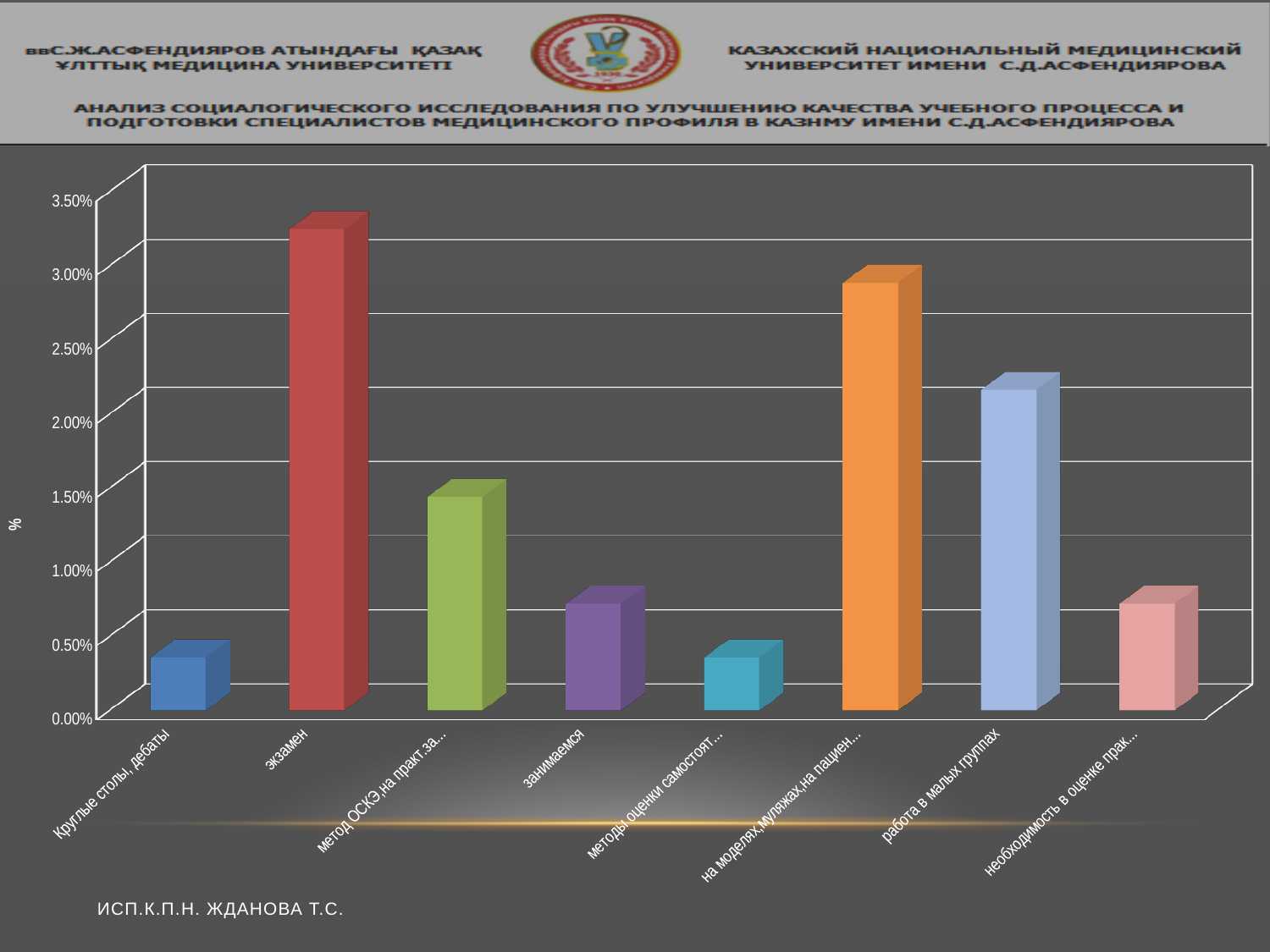
Is the value for на моделях,муляжах,на пациен... greater or less than 2.50%? greater Which is larger: the value for занимаемся or the value for методы оценки самостоят...? занимаемся Which category has the highest value on the chart? экзамен Is the value for экзамен greater or less than 3.00%? greater Which is larger: the value for экзамен or the value for на моделях,муляжах,на пациен...? экзамен Is the value for метод ОСКЭ,на практ.за... greater or less than 2.00%? less Which is larger: the value for работа в малых группах or the value for метод ОСКЭ,на практ.за...? работа в малых группах How many categories are plotted on the chart? 8 What kind of chart is shown on the slide? bar chart What is the label on the vertical axis of the chart? %